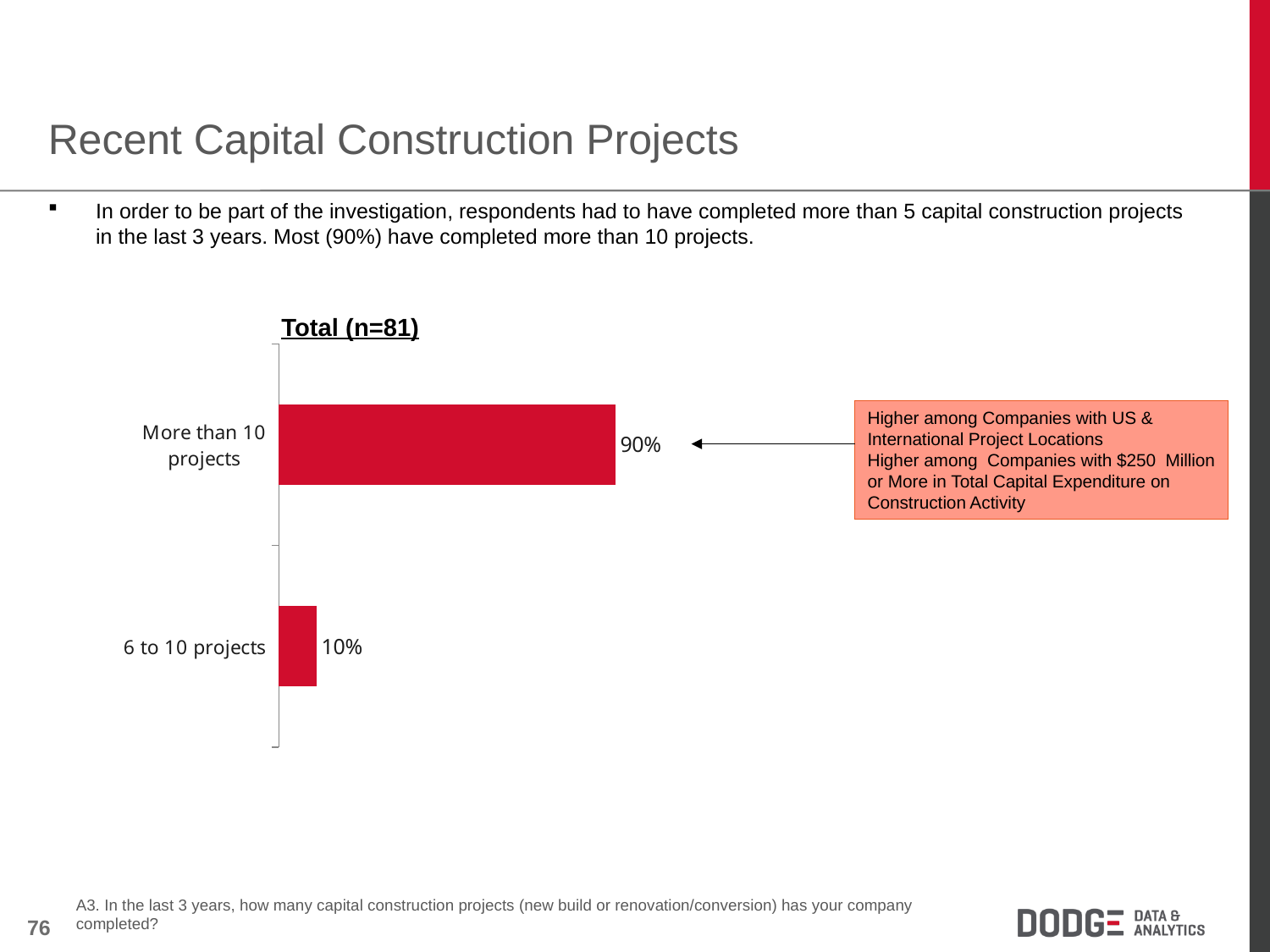
What percentage of respondents completed more than 10 projects? 90% What colour are the bars in the chart? Red What is the total of the two values shown in the chart? 100% What is the title of the chart? Total (n=81) Which category has the lowest value? 6 to 10 projects Which is larger: the value for 'More than 10 projects' or '6 to 10 projects'? More than 10 projects How many categories are shown in the chart? 2 Which category has the highest value? More than 10 projects What percentage of respondents completed 6 to 10 projects? 10% What kind of chart is shown on the slide? Bar chart What is the difference between the values for 'More than 10 projects' and '6 to 10 projects'? 80 percentage points